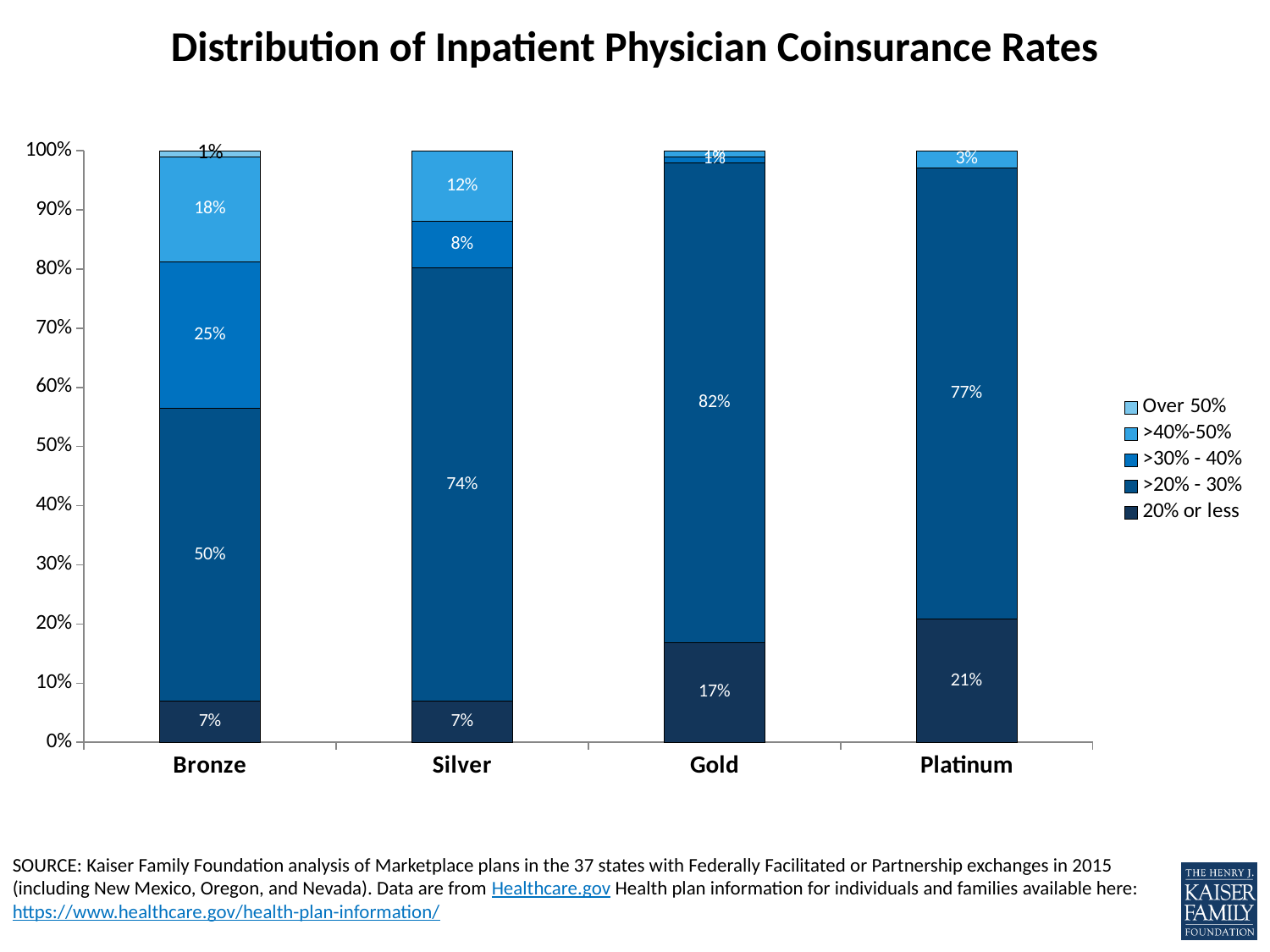
What share of Silver plans fall in the >20% - 30% coinsurance category? 74% Which plan category has the largest share in the >20% - 30% coinsurance range? Gold What share of Bronze plans have an inpatient physician coinsurance rate of >20% - 30%? 50% How many plan categories are shown on the x axis? 4 What share of Platinum plans have a coinsurance rate of 20% or less? 21% What share of Gold plans have a coinsurance rate of 20% or less? 17% How many series does the legend list? 5 What kind of chart is shown on the slide? Stacked bar chart Which has a larger share in the >30% - 40% coinsurance range, Bronze or Silver? Bronze What share of Bronze plans fall in the >40%-50% coinsurance category? 18% Which plan category has the largest share of plans with coinsurance of 20% or less? Platinum What is the difference in percentage points between the >20% - 30% share for Gold and for Platinum? 5 percentage points